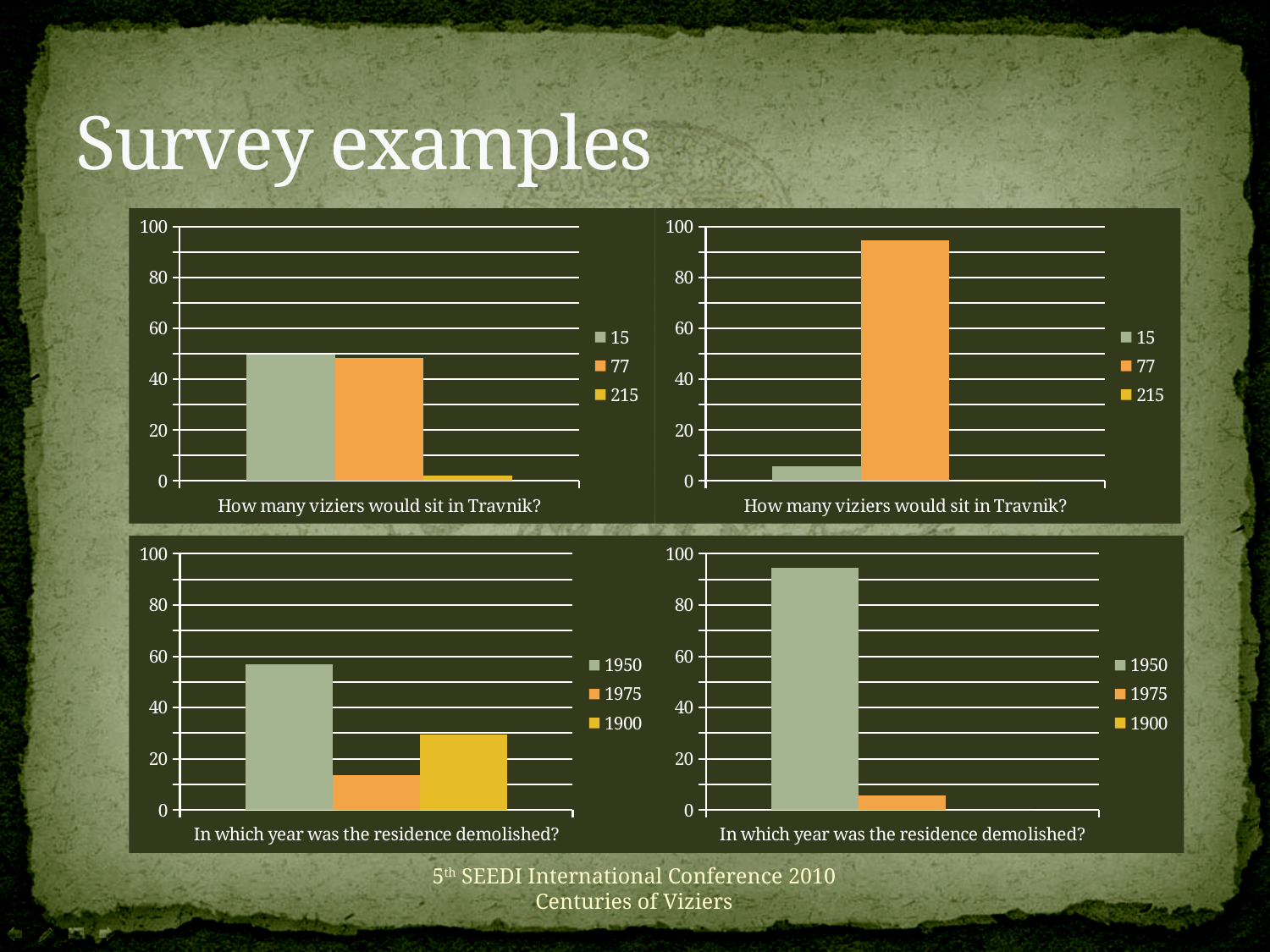
In the top-right chart, is the value for 77 greater or less than 80? greater What is the title of the bottom-right chart? In which year was the residence demolished? In the bottom-right chart, which is larger, the value for 1950 or the value for 1975? 1950 In the top-left chart, which series has the lowest bar? 215 In the top-right chart, which series has the highest bar? 77 In the top-right chart, is the value for 15 greater or less than 20? less In the bottom-right chart, is the value for 1950 greater or less than 80? greater What kind of chart is the top-left chart on the slide? bar chart In the bottom-left chart, which series has the highest bar? 1950 In the bottom-left chart, which series has the lowest bar? 1975 How many series does the legend of the top-right chart list? 3